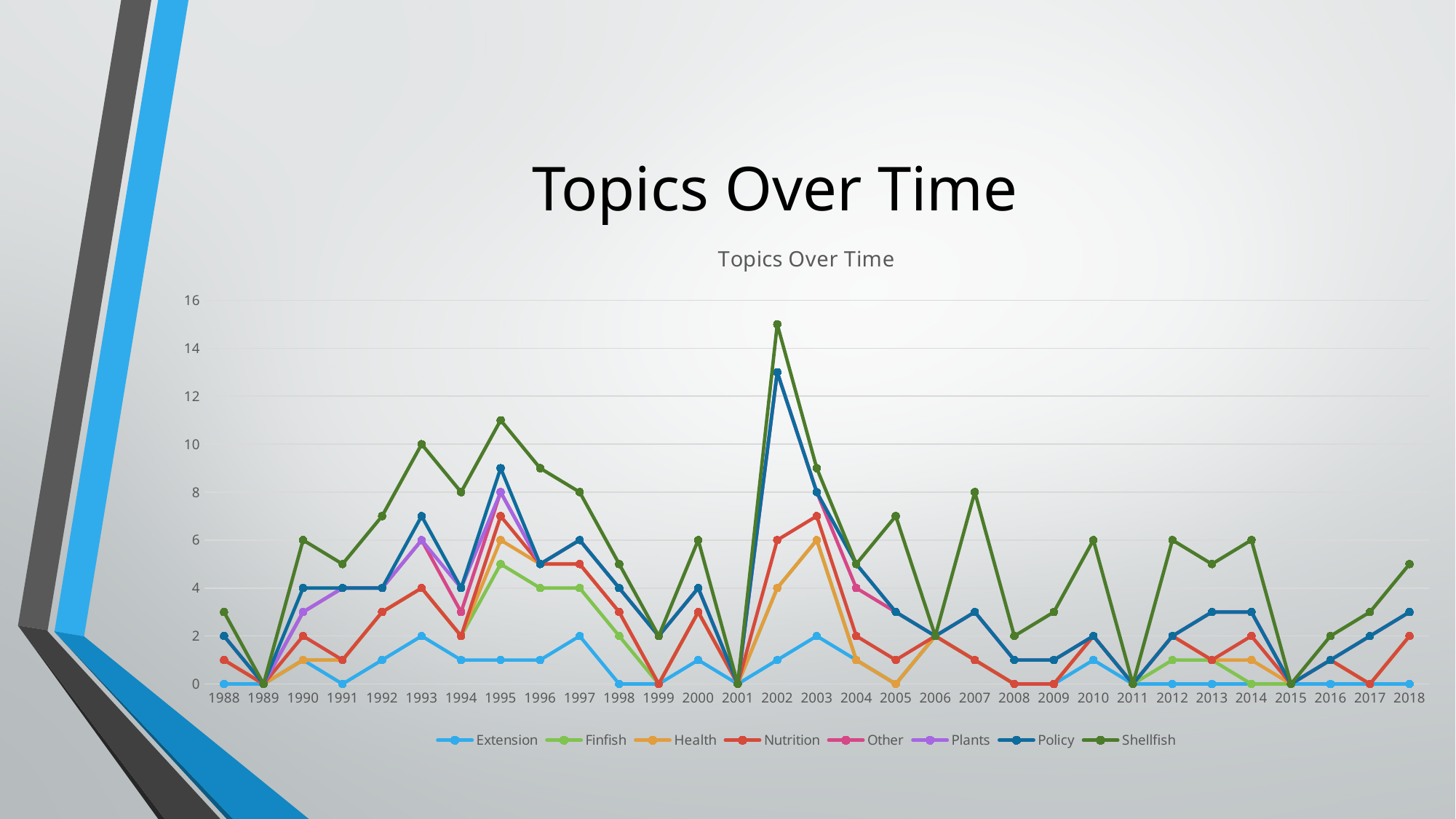
What kind of chart is shown on the slide? line chart How many series does the legend list? 8 How many years are shown along the x axis? 31 Which is larger in 1993, the value for Shellfish or the value for Policy? Shellfish Does the Shellfish series rise or fall from 2015 to 2018? rise